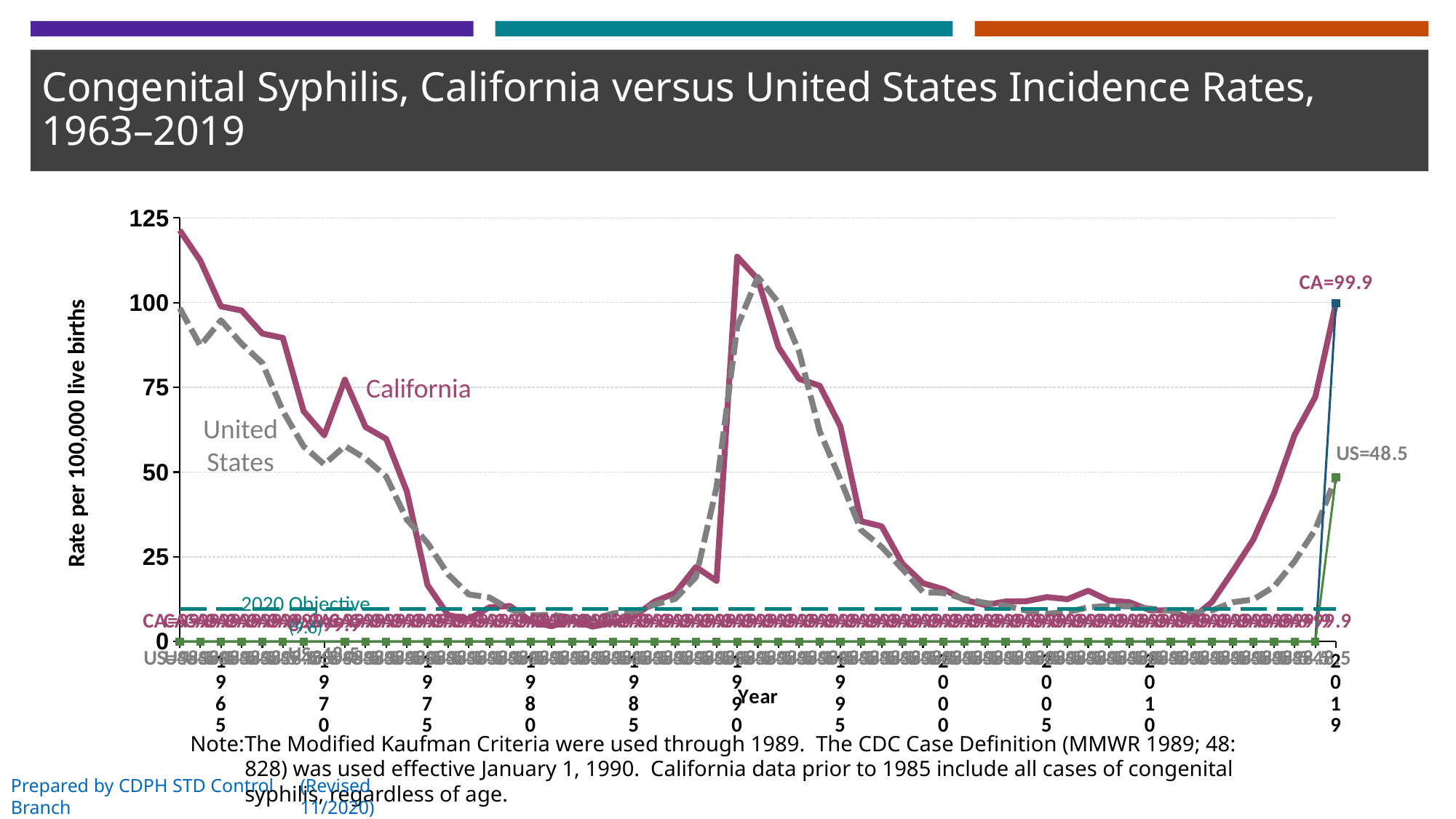
Is the United States rate in 2000 greater or less than 25? less Does the California rate rise or fall between 2010 and 2019? rise What kind of chart is shown on the slide? line chart Is the United States rate in 1980 greater or less than 25? less Is the California rate in 1965 greater or less than 75? greater What is the title of the y axis? Rate per 100,000 live births What is the title of the x axis? Year What is the California congenital syphilis rate in 2019? 99.9 What is the United States congenital syphilis rate in 2019? 48.5 In 2019, which has the higher rate, California or the United States? California Does the California rate rise or fall between 1963 and 1975? fall What is the difference between the California and United States rates in 2019? 51.4